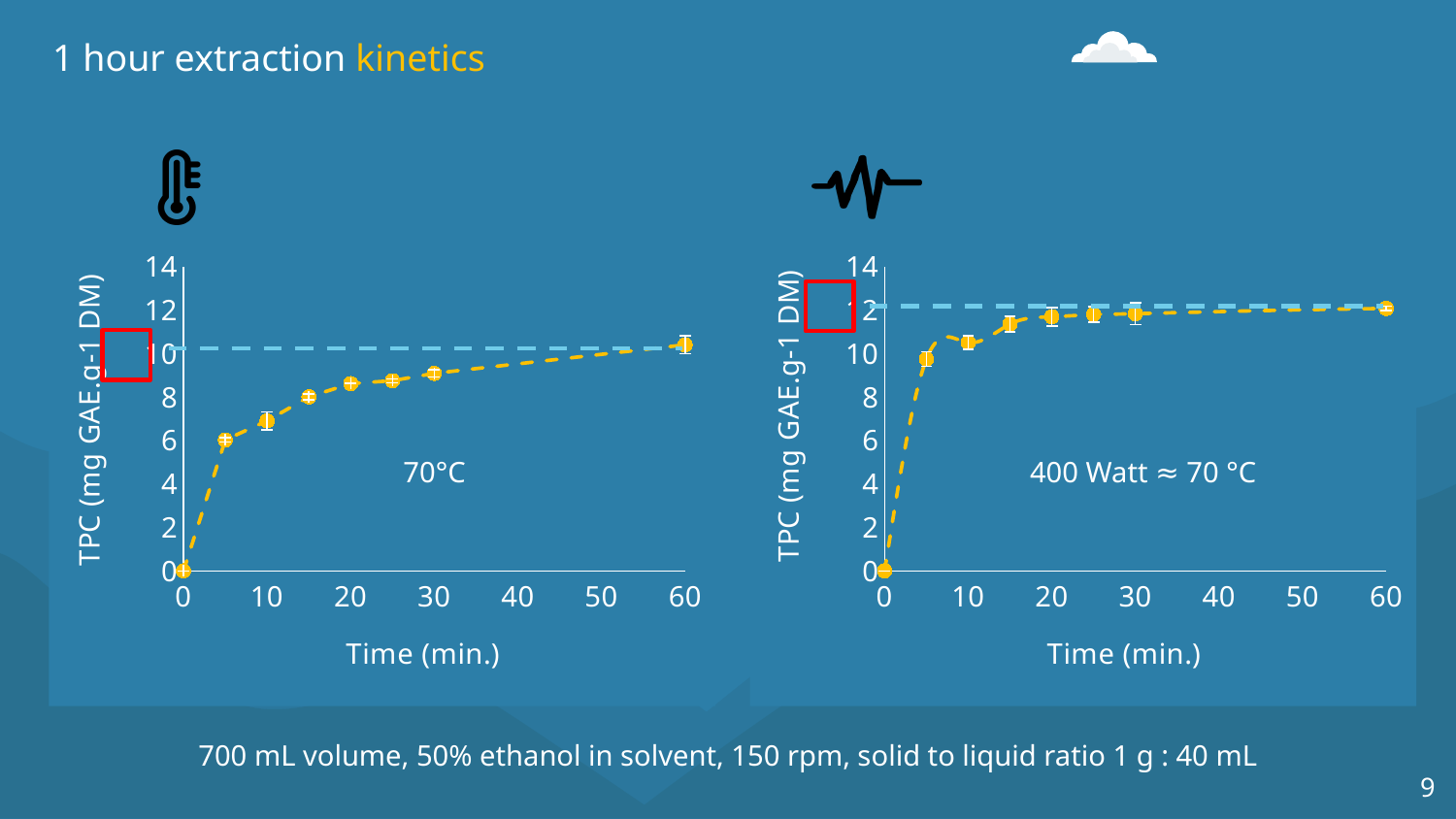
In the left chart (70°C), is the TPC value at 60 minutes greater or less than 8? greater What is the y-axis label of the right chart (400 Watt ≈ 70 °C)? TPC (mg GAE.g-1 DM) In the left chart (70°C), do the TPC values rise or fall as time increases? rise In the right chart (400 Watt ≈ 70 °C), how many data points are plotted along the time axis? 8 What is the x-axis label of the left chart (70°C)? Time (min.) In the right chart (400 Watt ≈ 70 °C), do the TPC values rise or fall as time increases? rise Which chart reaches a higher TPC value at 60 minutes, the left chart (70°C) or the right chart (400 Watt ≈ 70 °C)? the right chart (400 Watt ≈ 70 °C) In the right chart (400 Watt ≈ 70 °C), is the TPC value at 10 minutes greater or less than 8? greater In the right chart (400 Watt ≈ 70 °C), is the TPC value at 60 minutes greater or less than 10? greater In the left chart (70°C), how many data points are plotted along the time axis? 8 What kind of chart is the left chart labelled 70°C? line chart